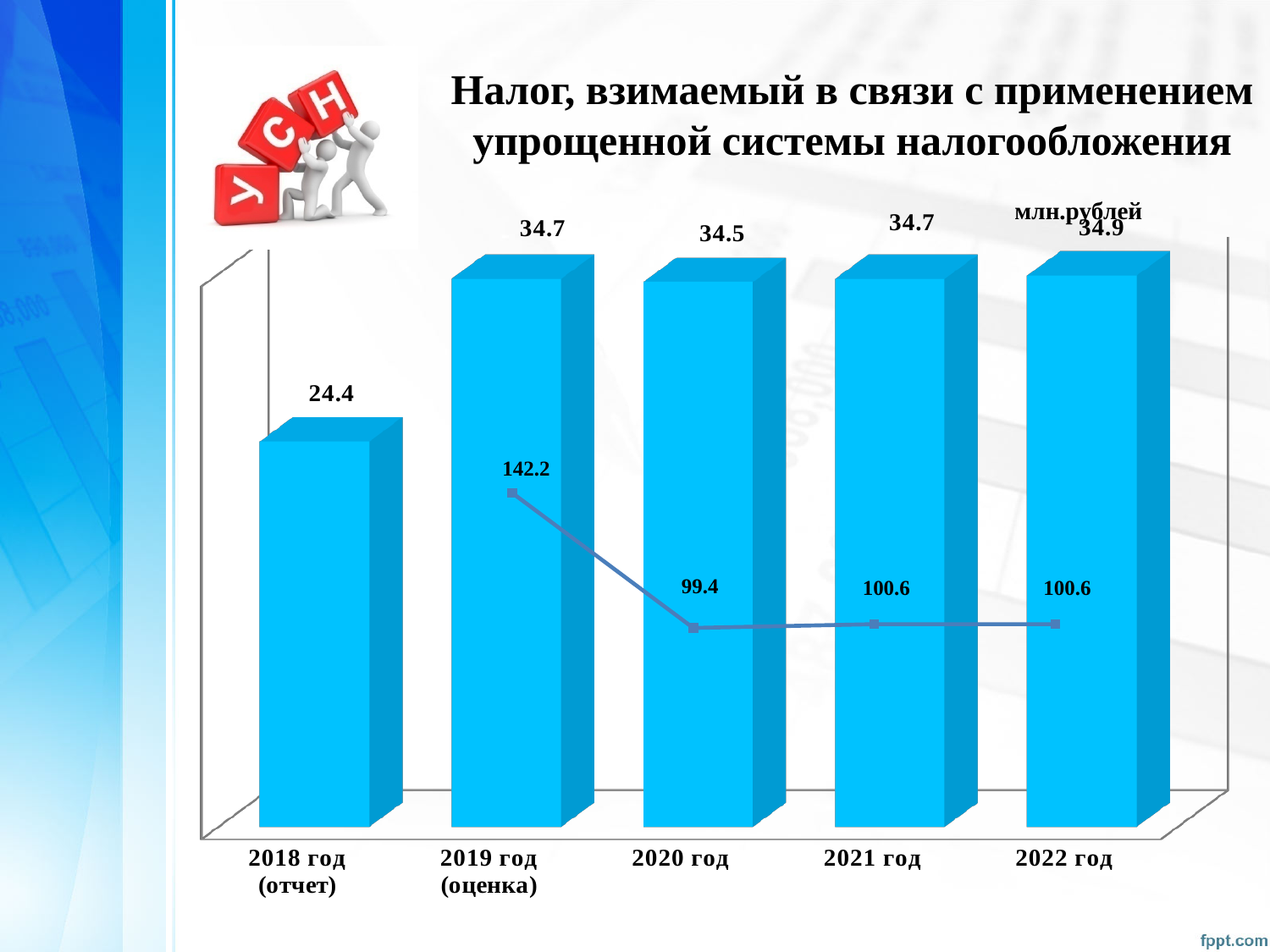
What is the line value shown for 2020 год? 99.4 What is the difference between the bar values for 2019 год (оценка) and 2018 год (отчет)? 10.3 What is the bar value for 2020 год? 34.5 What is the line value shown for 2019 год (оценка)? 142.2 Which is larger, the line value for 2019 год (оценка) or for 2020 год? 2019 год (оценка) Which year has the highest bar value? 2022 год What is the bar value for 2022 год? 34.9 What unit is stated for the values on the chart? млн.рублей How many years are shown on the x axis? 5 What kind of chart is shown on the slide? Combined bar and line chart What is the bar value for 2018 год (отчет)? 24.4 Which year has the lowest bar value? 2018 год (отчет)